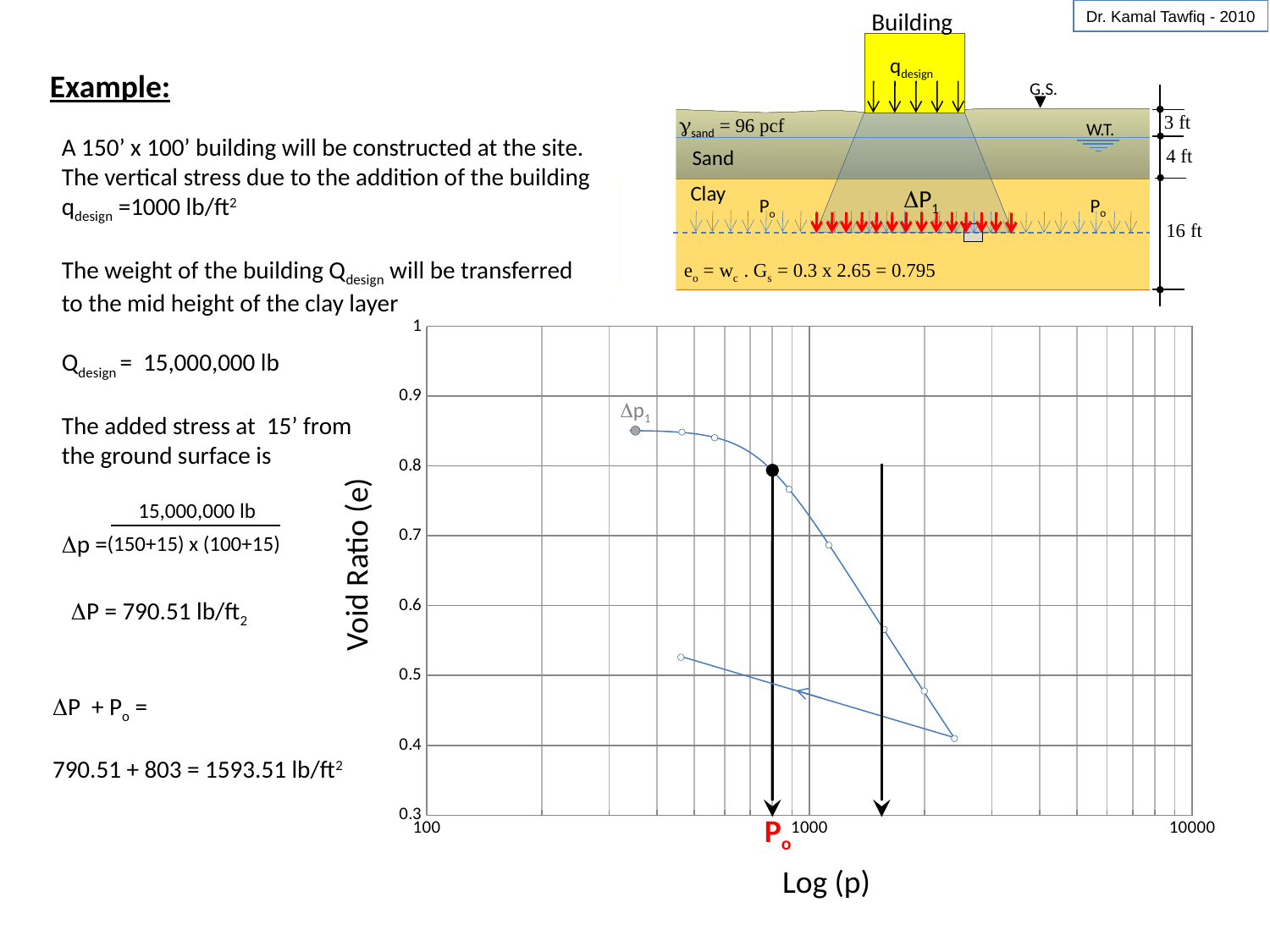
What is the lowest value shown on the vertical axis of the chart? 0.3 Which has the larger void ratio: the point labelled Δp1 or the point above Po? Δp1 What is the title of the vertical axis of the chart? Void Ratio (e) Is the highest void ratio plotted on the curve greater or less than 0.8? greater What kind of chart is shown on the slide? line chart Is the void ratio at the point labelled Δp1 greater or less than 0.8? greater Is the pressure value marked Po on the x axis greater or less than 1000? less Along the loading curve, does the void ratio rise or fall as p increases? fall What is the title of the horizontal axis of the chart? Log (p)